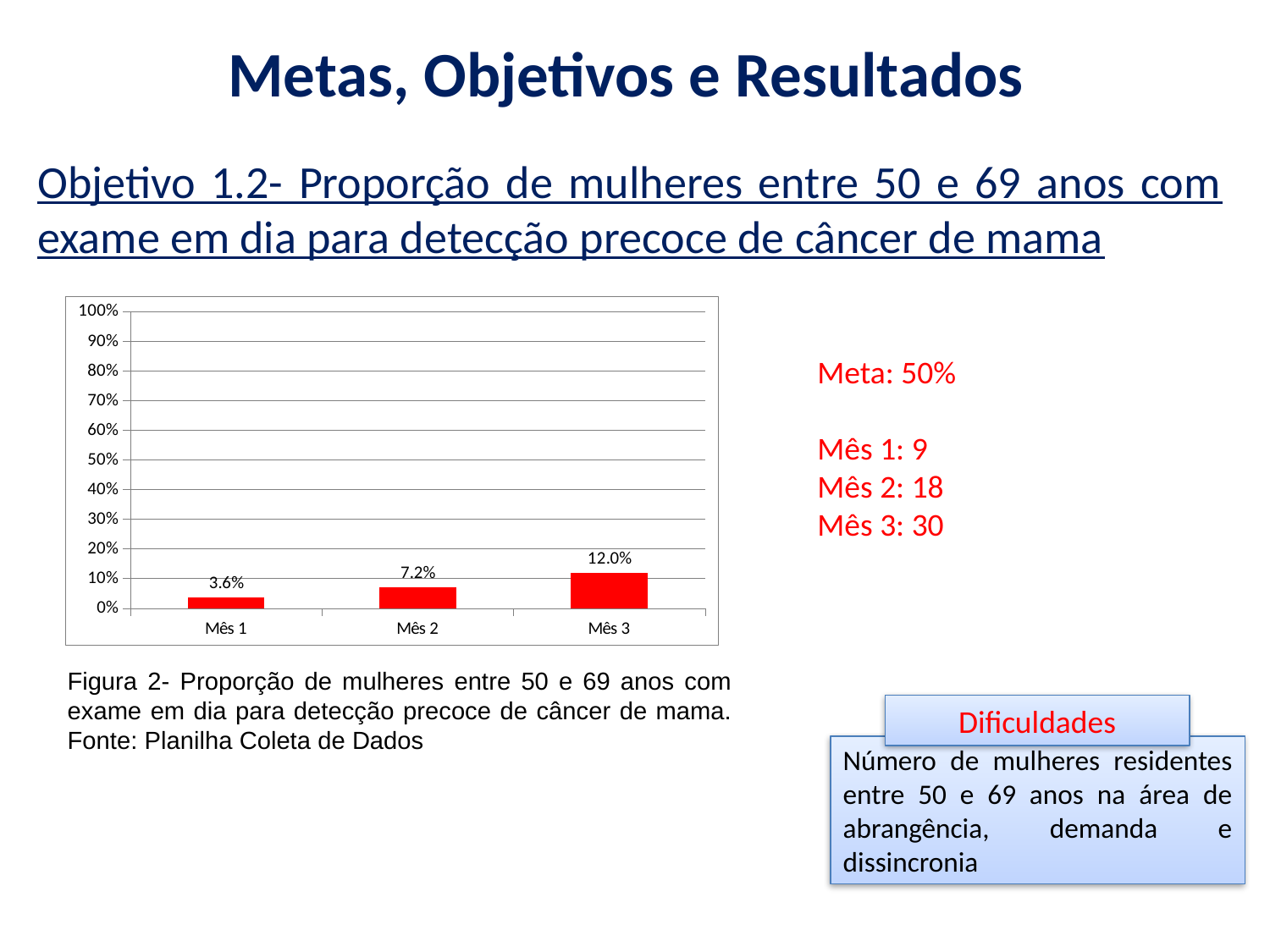
What is the difference between the values for Mês 3 and Mês 1? 8.4% Is the value for Mês 3 greater or less than 20%? less Which category has the highest value? Mês 3 What is the value for Mês 2? 7.2% What kind of chart is shown on the slide? bar chart How many categories are shown on the x axis? 3 What is the value for Mês 3? 12.0% Which category has the lowest value? Mês 1 Which is larger, the value for Mês 2 or the value for Mês 3? Mês 3 What is the value for Mês 1? 3.6% What is the difference between the values for Mês 2 and Mês 1? 3.6% Do the values rise or fall from Mês 1 to Mês 3? rise